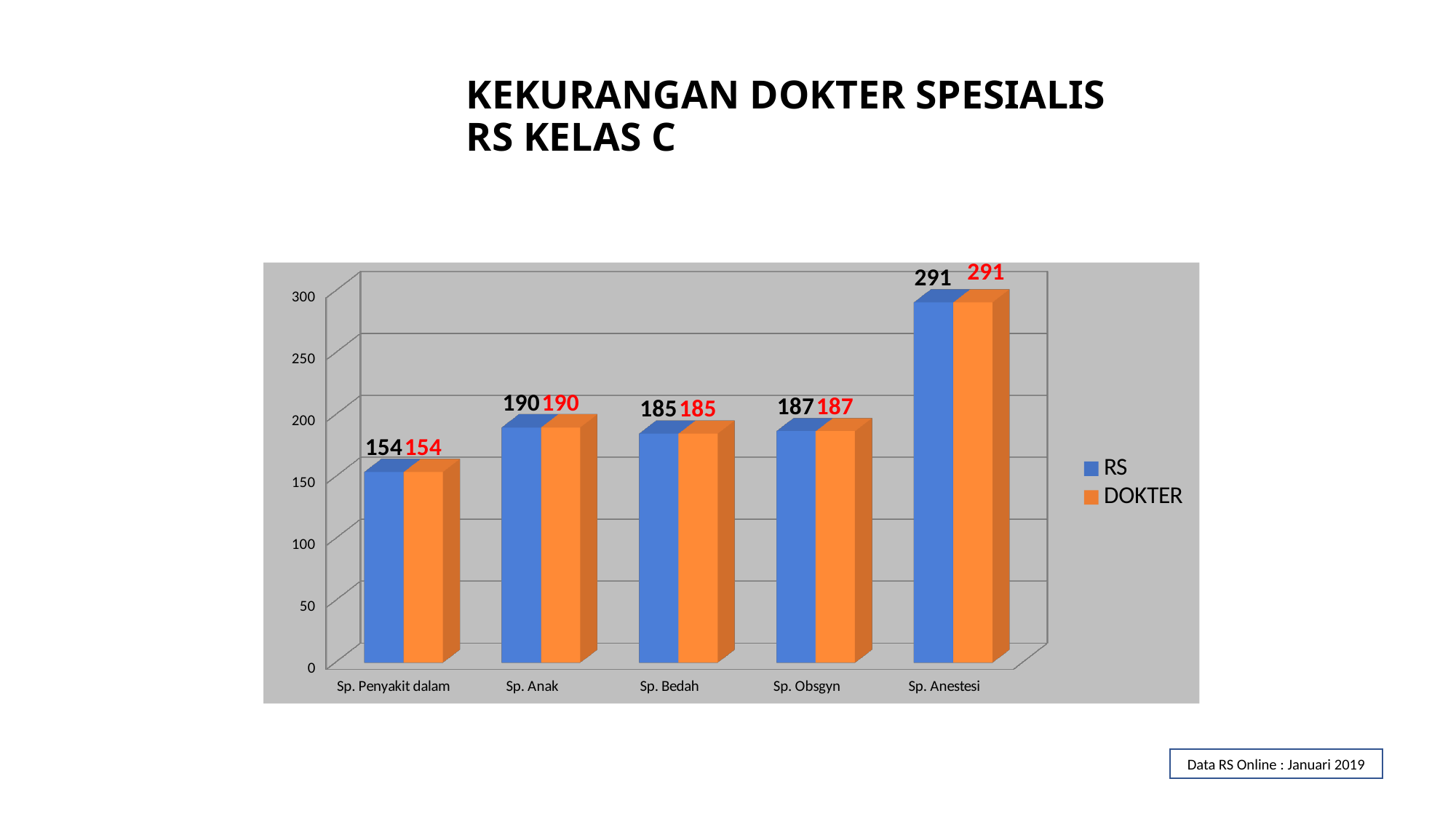
What is the title of the slide? KEKURANGAN DOKTER SPESIALIS RS KELAS C What is the difference between the RS value for Sp. Anestesi and the RS value for Sp. Anak? 101 Which is larger, the DOKTER value for Sp. Anak or the DOKTER value for Sp. Bedah? Sp. Anak What kind of chart is shown on the slide? bar chart How many categories are shown on the x axis? 5 Which category has the highest RS value? Sp. Anestesi How many series does the legend list? 2 Which category has the lowest DOKTER value? Sp. Penyakit dalam What is the RS value for Sp. Anestesi? 291 What is the DOKTER value for Sp. Obsgyn? 187 What is the RS value for Sp. Bedah? 185 What is the DOKTER value for Sp. Penyakit dalam? 154